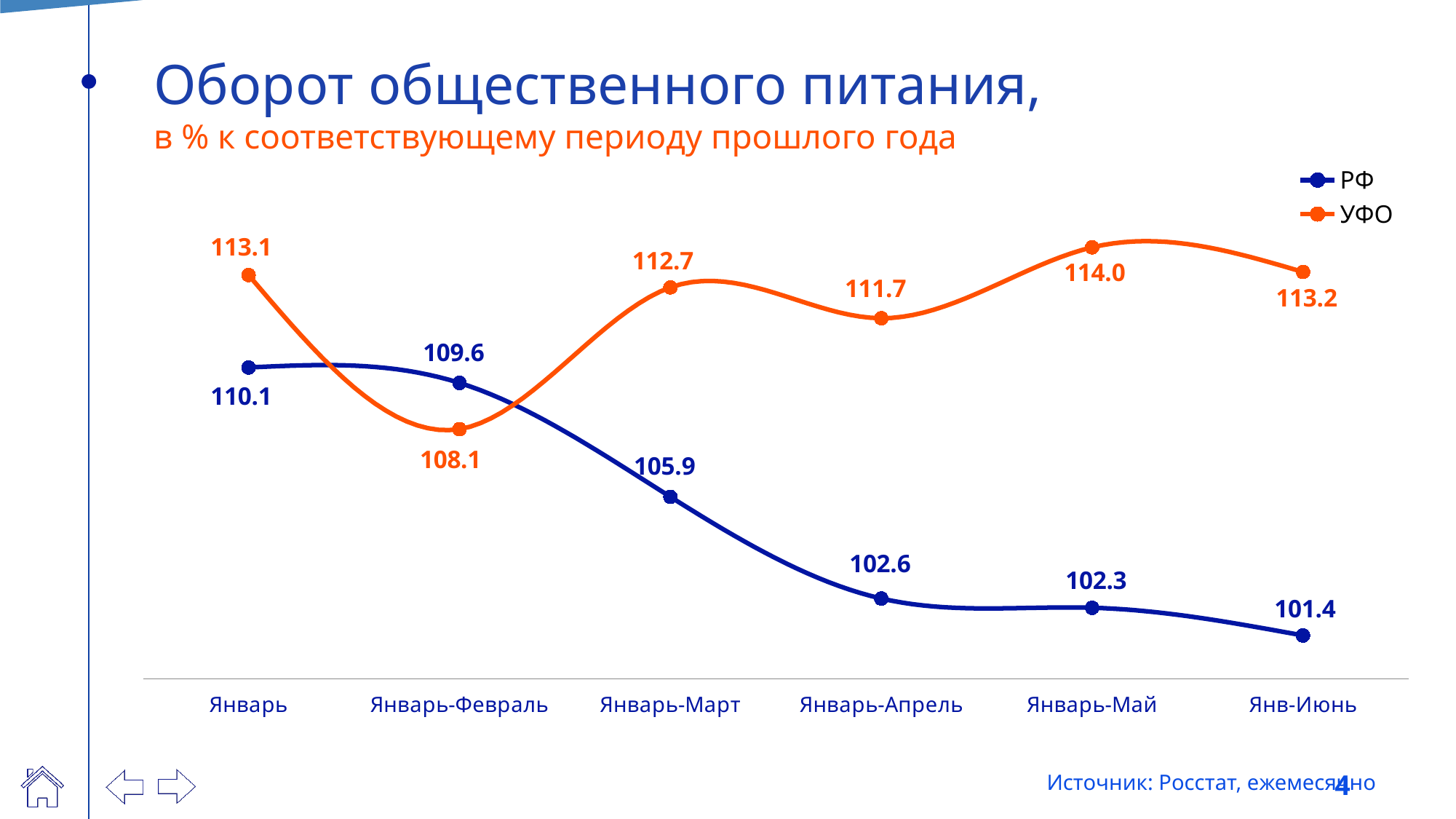
Does the РФ series rise or fall from Январь to Янв-Июнь? Fall What type of chart is shown on the slide? Line chart What is the value for УФО in Янв-Июнь? 113.2 In which period is the РФ series lowest? Янв-Июнь In which period is the УФО series highest? Январь-Май Which series has the larger value in Январь-Февраль, РФ or УФО? РФ How many periods are shown on the x axis? 6 How many series does the legend list? 2 What is the difference between УФО and РФ in Январь-Май? 11.7 What is the value for РФ in Январь-Март? 105.9 What is the subtitle of the chart shown in orange under the title? в % к соответствующему периоду прошлого года What is the value for УФО in Январь-Февраль? 108.1